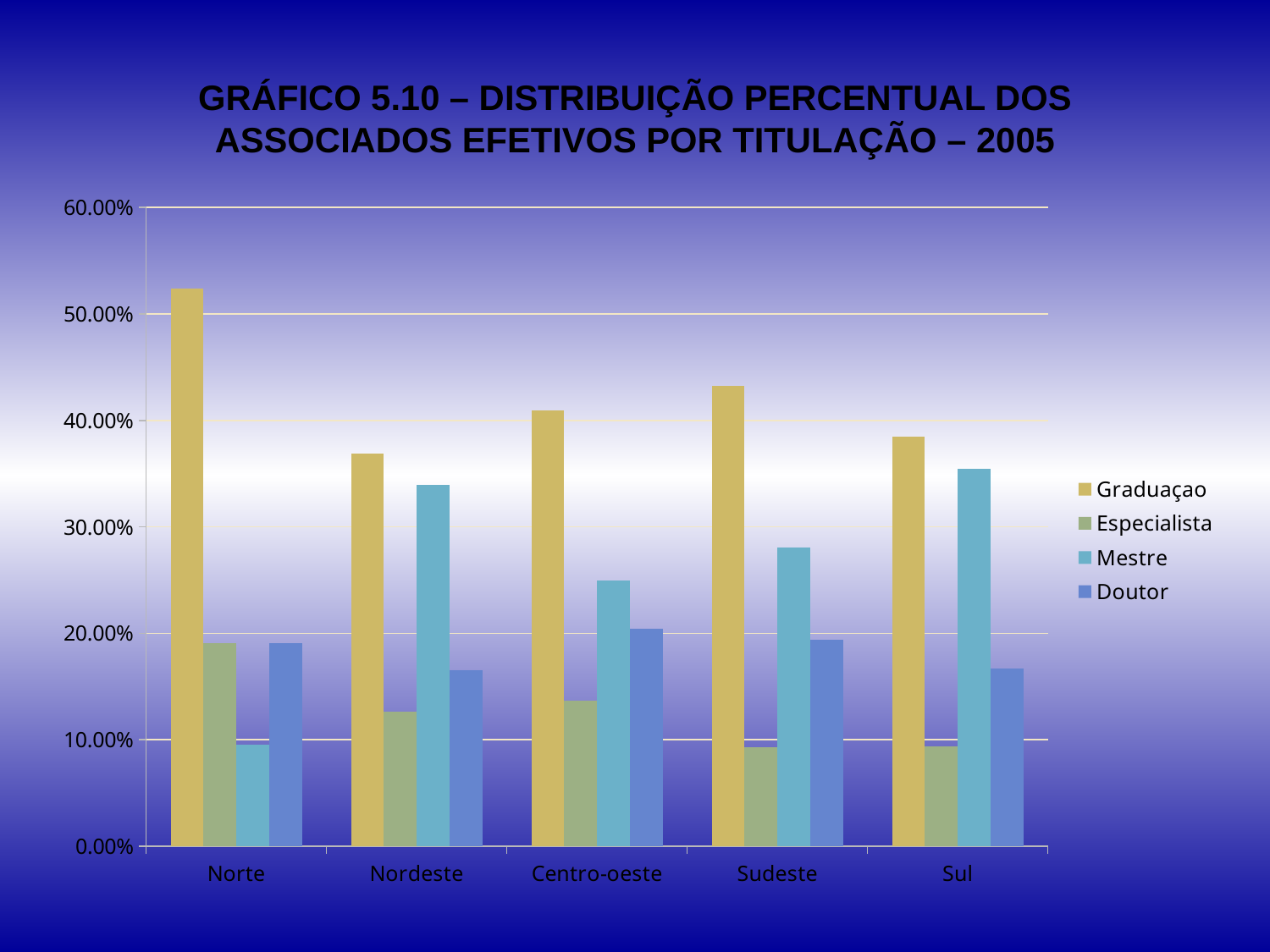
Which region has the highest value for Especialista? Norte How many regions are shown on the x axis? 5 What kind of chart is shown on the slide? Bar chart In Centro-oeste, which is larger: Graduaçao or Mestre? Graduaçao Is the value for Mestre in Sul greater or less than 30.00%? greater Is the value for Graduaçao in Norte greater or less than 50.00%? greater How many series does the legend list? 4 Is the value for Graduaçao in Sudeste greater or less than 40.00%? greater Which region has the lowest value for Mestre? Norte Which region has the highest value for Graduaçao? Norte In Nordeste, which is larger: Mestre or Doutor? Mestre